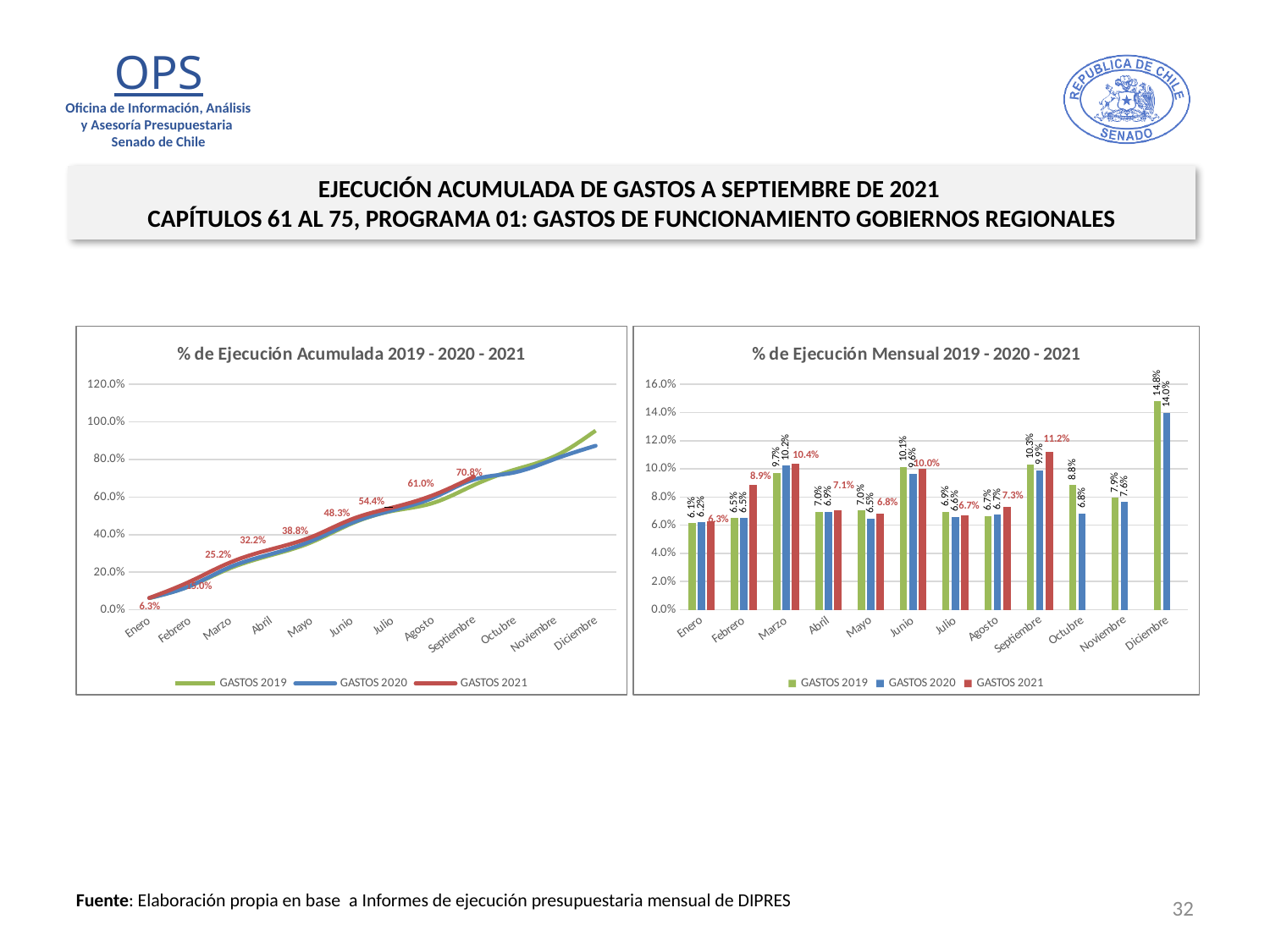
In the left chart '% de Ejecución Acumulada 2019 - 2020 - 2021', what is the GASTOS 2021 value for Septiembre? 70.8% In the left chart '% de Ejecución Acumulada 2019 - 2020 - 2021', does the GASTOS 2021 line rise or fall from Enero to Septiembre? Rises In the left chart '% de Ejecución Acumulada 2019 - 2020 - 2021', what is the GASTOS 2021 value for Marzo? 25.2% In the right chart '% de Ejecución Mensual 2019 - 2020 - 2021', what is the GASTOS 2021 value for Septiembre? 11.2% What kind of chart is the right chart, '% de Ejecución Mensual 2019 - 2020 - 2021'? Bar chart In the left chart '% de Ejecución Acumulada 2019 - 2020 - 2021', is the GASTOS 2019 value for Diciembre greater or less than 80.0%? greater In the left chart '% de Ejecución Acumulada 2019 - 2020 - 2021', what is the difference between the GASTOS 2021 values for Septiembre and Agosto? 9.8 percentage points In the right chart '% de Ejecución Mensual 2019 - 2020 - 2021', which is larger for Febrero: GASTOS 2020 or GASTOS 2021? GASTOS 2021 What kind of chart is the left chart, '% de Ejecución Acumulada 2019 - 2020 - 2021'? Line chart In the right chart '% de Ejecución Mensual 2019 - 2020 - 2021', which month has the highest GASTOS 2019 value? Diciembre In the right chart '% de Ejecución Mensual 2019 - 2020 - 2021', how many months are shown on the x axis? 12 How many series does the legend of the left chart '% de Ejecución Acumulada 2019 - 2020 - 2021' list? 3